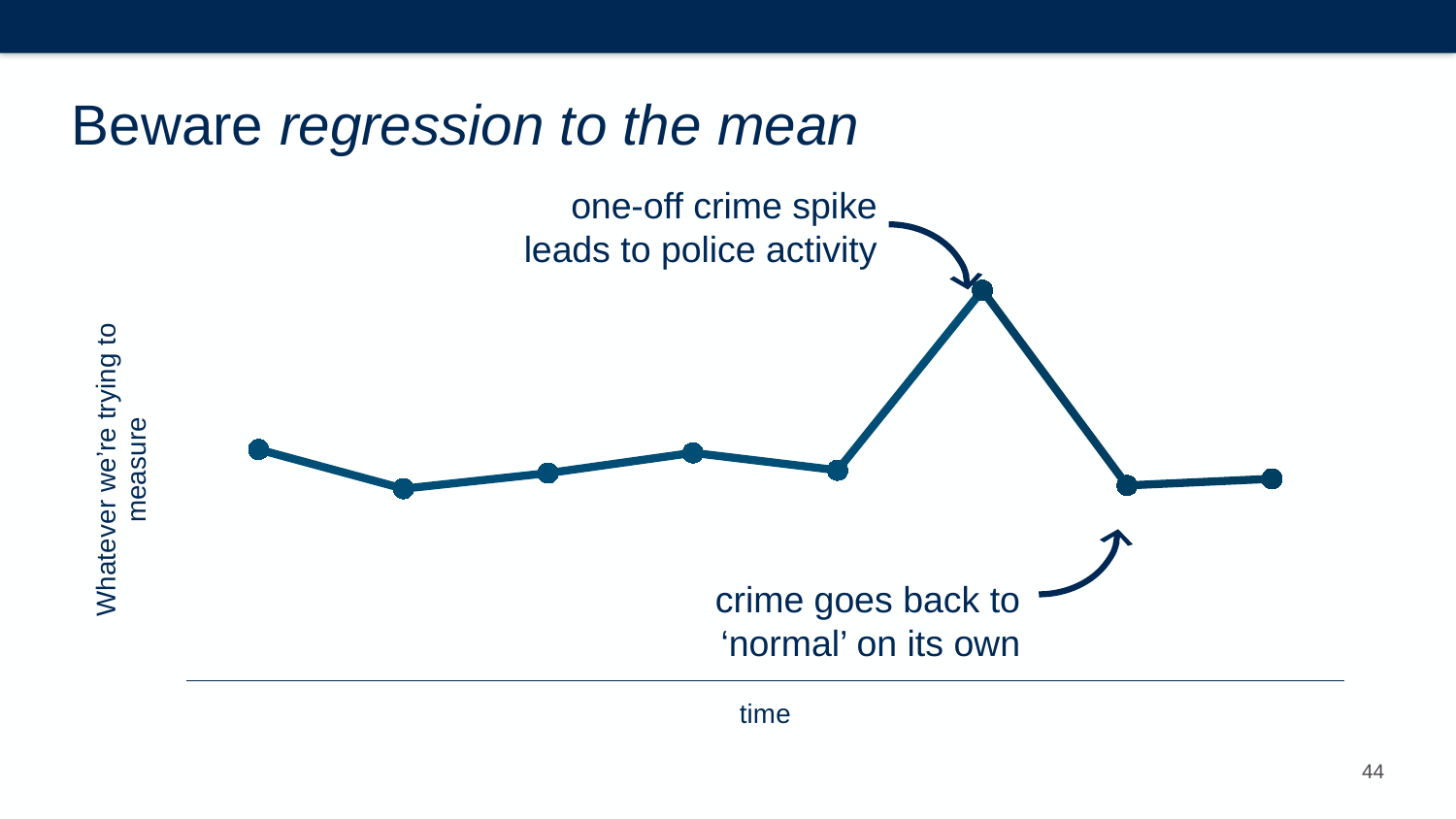
Which data point, counting from the left, has the highest value? the sixth point Which is larger, the value at the fourth point or the value at the second point? the fourth point What is the label on the x axis of the chart? time Does the line rise or fall between the first and second points? fall Which is larger, the value at the sixth point or the value at the first point? the sixth point Does the line rise or fall between the fifth and sixth points? rise What kind of chart is shown on the slide? line chart Does the line rise or fall between the sixth and seventh points? fall What is the label on the y axis of the chart? Whatever we're trying to measure How many data points are plotted on the line? 8